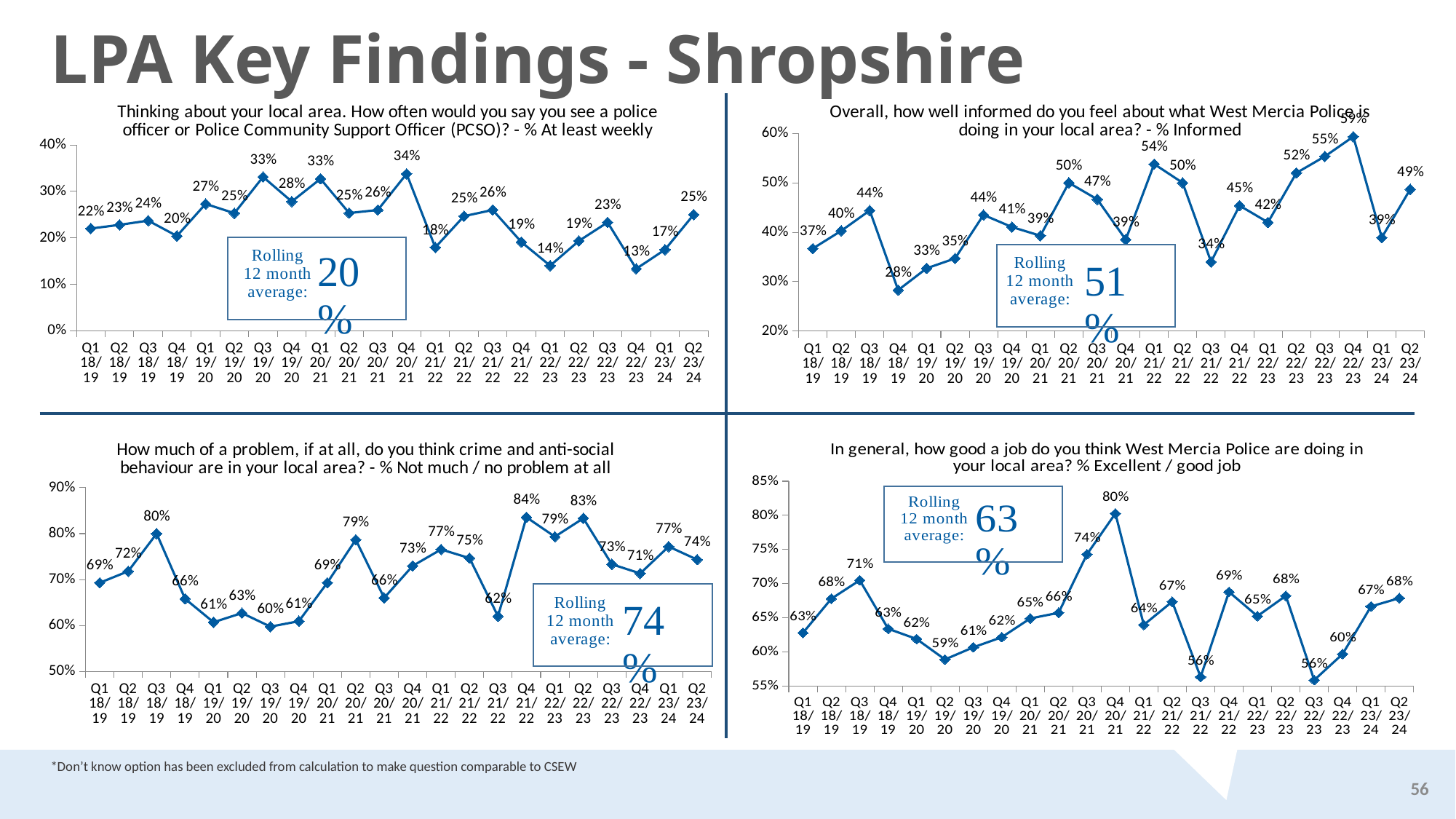
In the chart about West Mercia Police doing an excellent / good job, what is the value for Q4 20/21? 80% In the chart about seeing a police officer or PCSO at least weekly, what is the rolling 12 month average shown? 20% In the chart about West Mercia Police doing an excellent / good job, what is the rolling 12 month average shown? 63% In the chart about how well informed people feel, which quarter has the lowest value? Q4 18/19 In the chart about how well informed people feel, what is the value for Q4 22/23? 59% How many quarters are plotted in the chart about West Mercia Police doing an excellent / good job? 22 In the chart about how well informed people feel, what is the difference between Q4 22/23 and Q1 23/24? 20 percentage points In the chart about seeing a police officer or PCSO at least weekly, what is the value for Q4 20/21? 34% In the chart about crime and anti-social behaviour being not much / no problem, what is the value for Q3 18/19? 80% In the chart about crime and anti-social behaviour being not much / no problem, is the value for Q2 22/23 larger or smaller than the value for Q3 22/23? larger In the chart about crime and anti-social behaviour being not much / no problem, which quarter has the highest value? Q4 21/22 In the chart about seeing a police officer or PCSO at least weekly, which quarter has the lowest value? Q4 22/23